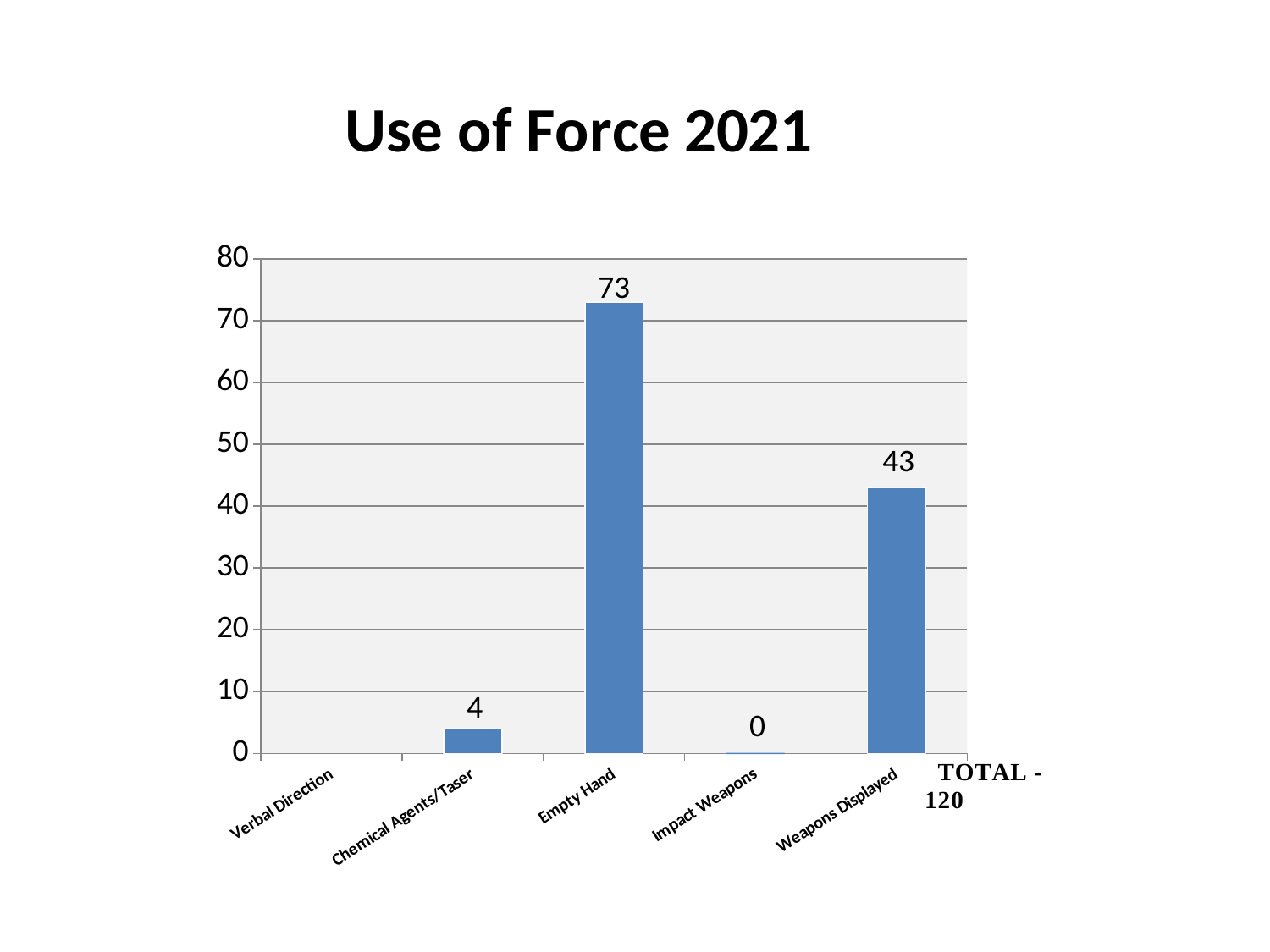
What is the value for Impact Weapons? 0 What is the value for Weapons Displayed? 43 What is the difference between the values for Empty Hand and Weapons Displayed? 30 What is the value for Empty Hand? 73 Is the value for Empty Hand greater or less than 70? greater What is the value for Chemical Agents/Taser? 4 How many categories are shown on the x axis? 5 Which category has the highest value? Empty Hand What kind of chart is shown on the slide? bar chart What is the title of the chart? Use of Force 2021 Which is larger, the value for Weapons Displayed or the value for Chemical Agents/Taser? Weapons Displayed What is the difference between the values for Weapons Displayed and Chemical Agents/Taser? 39